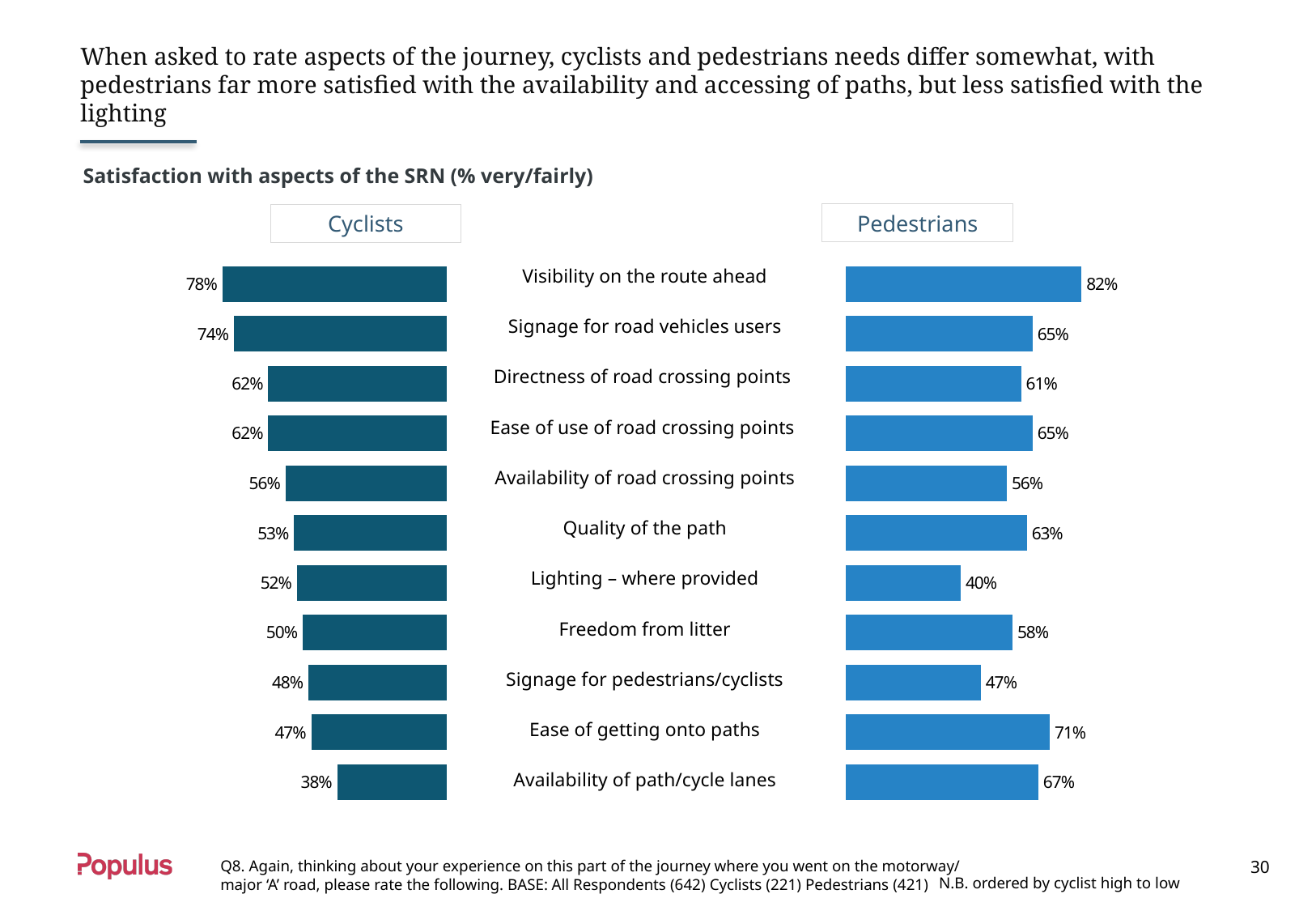
For Lighting – where provided, which group has the higher satisfaction, Cyclists or Pedestrians? Cyclists In the Cyclists chart, what is the value for Visibility on the route ahead? 78% In the Cyclists chart, which aspect has the lowest satisfaction? Availability of path/cycle lanes In the Pedestrians chart, which aspect has the highest satisfaction? Visibility on the route ahead What is the difference between the Pedestrians and Cyclists values for Availability of path/cycle lanes? 29 percentage points In the Cyclists chart, do the values rise or fall from the top aspect to the bottom aspect? Fall How many aspects are listed in the Cyclists chart? 11 What type of chart is used to show the Cyclists satisfaction data? Bar chart In the Pedestrians chart, what is the value for Ease of getting onto paths? 71% In the Pedestrians chart, which aspect has the lowest satisfaction? Lighting – where provided For Ease of getting onto paths, which group has the higher satisfaction, Cyclists or Pedestrians? Pedestrians In the Pedestrians chart, what is the value for Lighting – where provided? 40%